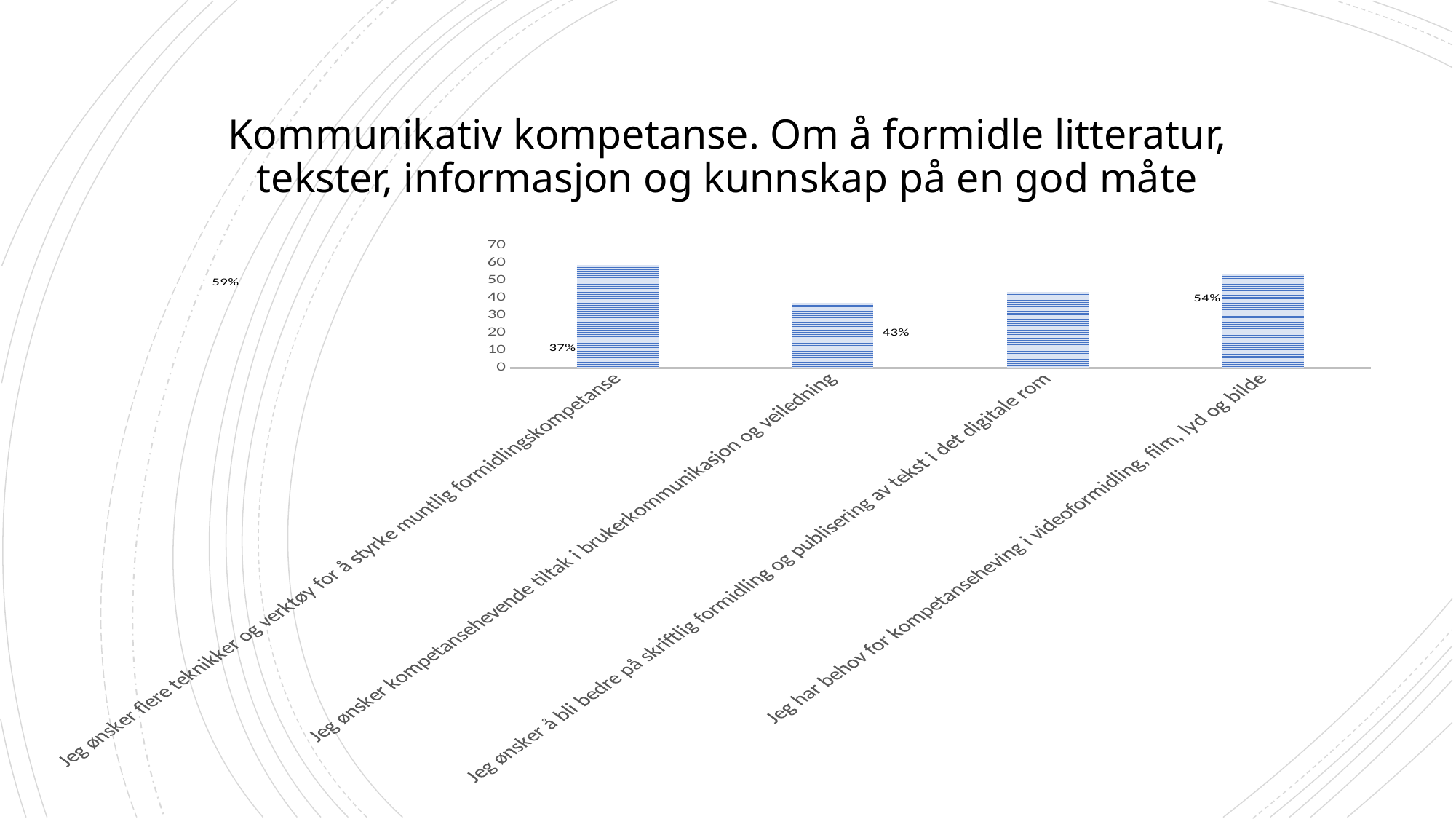
Which is larger: the bar for 'Jeg ønsker flere teknikker og verktøy for å styrke muntlig formidlingskompetanse' or the bar for 'Jeg ønsker kompetansehevende tiltak i brukerkommunikasjon og veiledning'? Jeg ønsker flere teknikker og verktøy for å styrke muntlig formidlingskompetanse Which is larger: the bar for 'Jeg ønsker å bli bedre på skriftlig formidling og publisering av tekst i det digitale rom' or the bar for 'Jeg har behov for kompetanseheving i videoformidling, film, lyd og bilde'? Jeg har behov for kompetanseheving i videoformidling, film, lyd og bilde Is the value for 'Jeg ønsker kompetansehevende tiltak i brukerkommunikasjon og veiledning' greater or less than 40? less Is the value for 'Jeg har behov for kompetanseheving i videoformidling, film, lyd og bilde' greater or less than 50? greater Is the value for 'Jeg ønsker flere teknikker og verktøy for å styrke muntlig formidlingskompetanse' greater or less than 50? greater What is the title of the slide containing the chart? Kommunikativ kompetanse. Om å formidle litteratur, tekster, informasjon og kunnskap på en god måte What is the highest tick value shown on the vertical axis? 70 How many categories (bars) does the chart show? 4 Which category has the lowest bar? Jeg ønsker kompetansehevende tiltak i brukerkommunikasjon og veiledning Which category has the highest bar? Jeg ønsker flere teknikker og verktøy for å styrke muntlig formidlingskompetanse What kind of chart is shown on the slide? bar chart